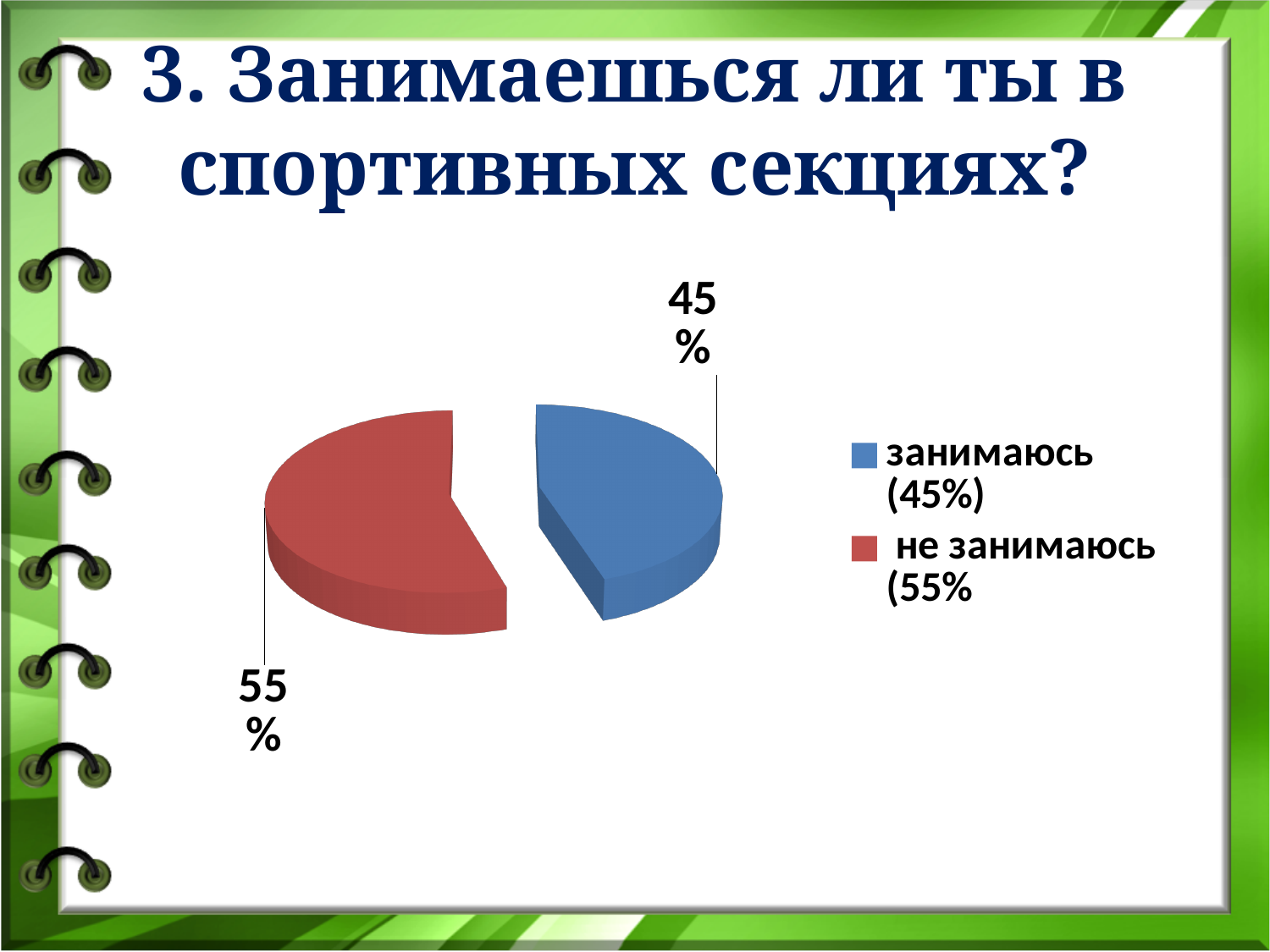
What share of the pie does the "занимаюсь" slice represent? 45% What percentage of the pie is labelled "занимаюсь"? 45% What colour is the "не занимаюсь" slice? red What kind of chart is shown on the slide? pie chart How many entries does the legend list? 2 What percentage of the pie is labelled "не занимаюсь"? 55% How many slices does the pie chart have? 2 What is the difference in percentage points between the "не занимаюсь" slice and the "занимаюсь" slice? 10 Which slice of the pie is the smallest? занимаюсь Which is larger: the "занимаюсь" slice or the "не занимаюсь" slice? не занимаюсь Which slice of the pie is the largest? не занимаюсь What colour is the "занимаюсь" slice? blue